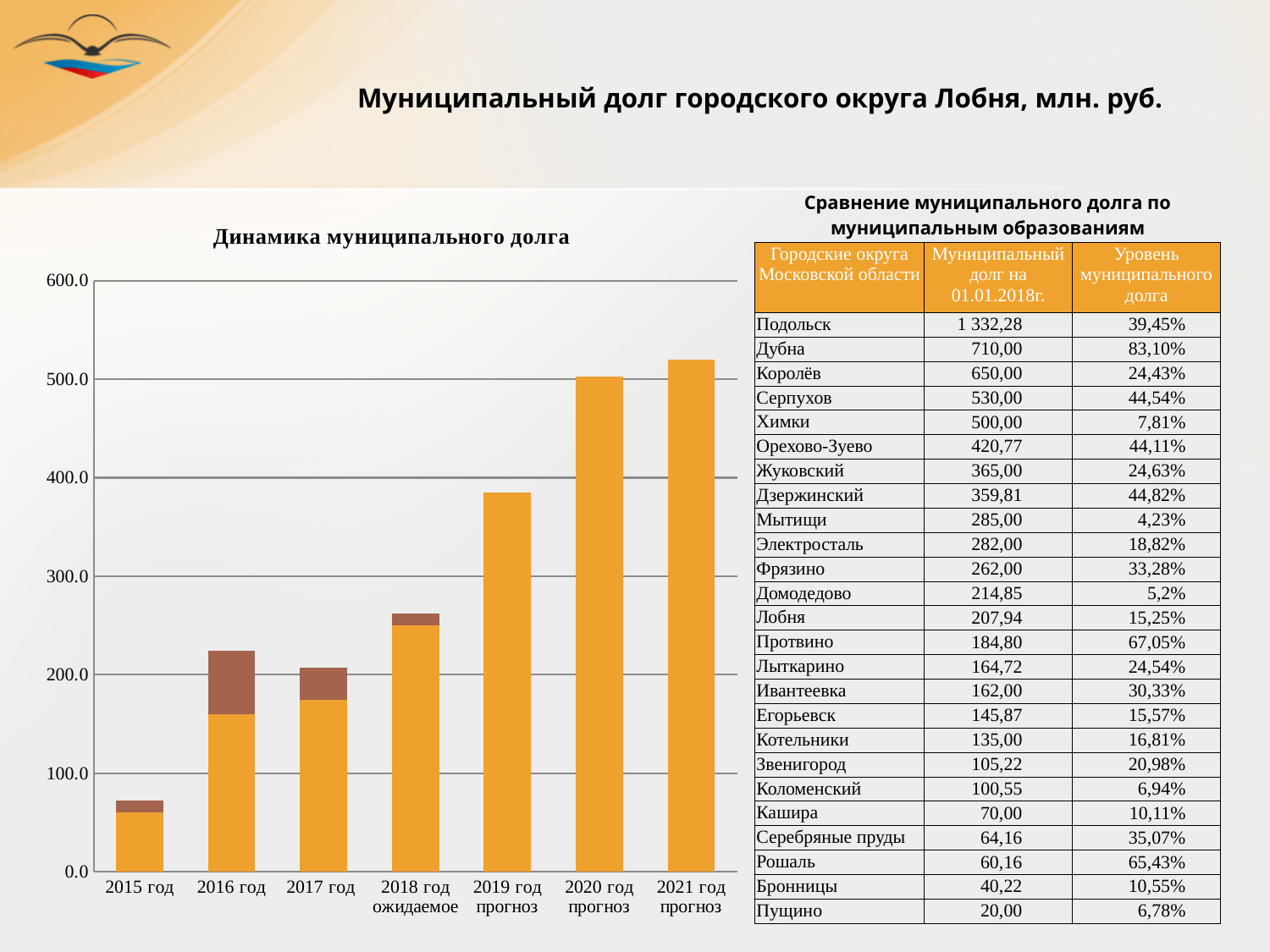
In the "Динамика муниципального долга" chart, which year has the lowest total bar? 2015 год In the "Динамика муниципального долга" chart, is the total value for 2018 год ожидаемое greater or less than 300.0? less In the "Динамика муниципального долга" chart, is the total value for 2015 год greater or less than 100.0? less In the "Динамика муниципального долга" chart, is the total value for 2020 год прогноз greater or less than 400.0? greater In the "Динамика муниципального долга" chart, which year has the highest total bar? 2021 год прогноз What kind of chart is "Динамика муниципального долга"? bar chart In the "Динамика муниципального долга" chart, do the total values generally rise or fall from 2015 год to 2021 год? rise How many years (categories) are shown on the x axis of the "Динамика муниципального долга" chart? 7 What is the title of the chart on the left of the slide? Динамика муниципального долга In the "Динамика муниципального долга" chart, which total bar is taller: 2018 год ожидаемое or 2019 год прогноз? 2019 год прогноз In the "Динамика муниципального долга" chart, which total bar is taller: 2016 год or 2017 год? 2016 год